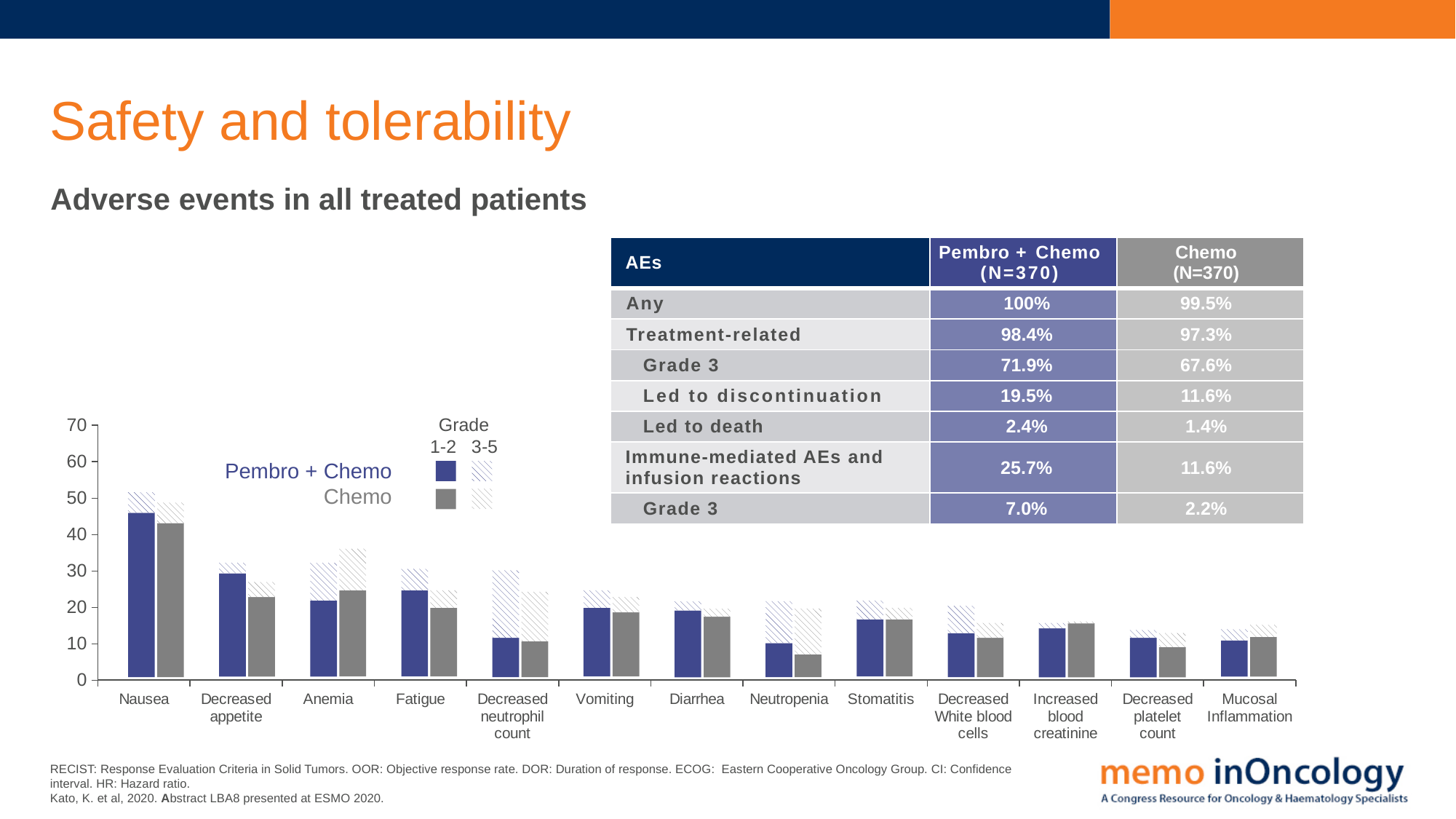
In the bar chart legend, what do the hatched bars represent? Grade 3-5 What kind of chart is shown on the slide? bar chart For Decreased appetite, which group has the larger Grade 1-2 bar, Pembro + Chemo or Chemo? Pembro + Chemo Is the Grade 1-2 value for Decreased appetite in the Pembro + Chemo group greater or less than 20? greater How many treatment groups does the bar chart legend list? 2 Is the Grade 1-2 value for Neutropenia in the Chemo group greater or less than 10? less For Anemia, which group has the larger Grade 1-2 bar, Pembro + Chemo or Chemo? Chemo Is the Grade 1-2 value for Fatigue in the Chemo group greater or less than 30? less How many adverse event categories are shown on the x axis of the bar chart? 13 What is the highest value shown on the y axis of the bar chart? 70 Which adverse event has the highest Grade 1-2 bar for Pembro + Chemo? Nausea